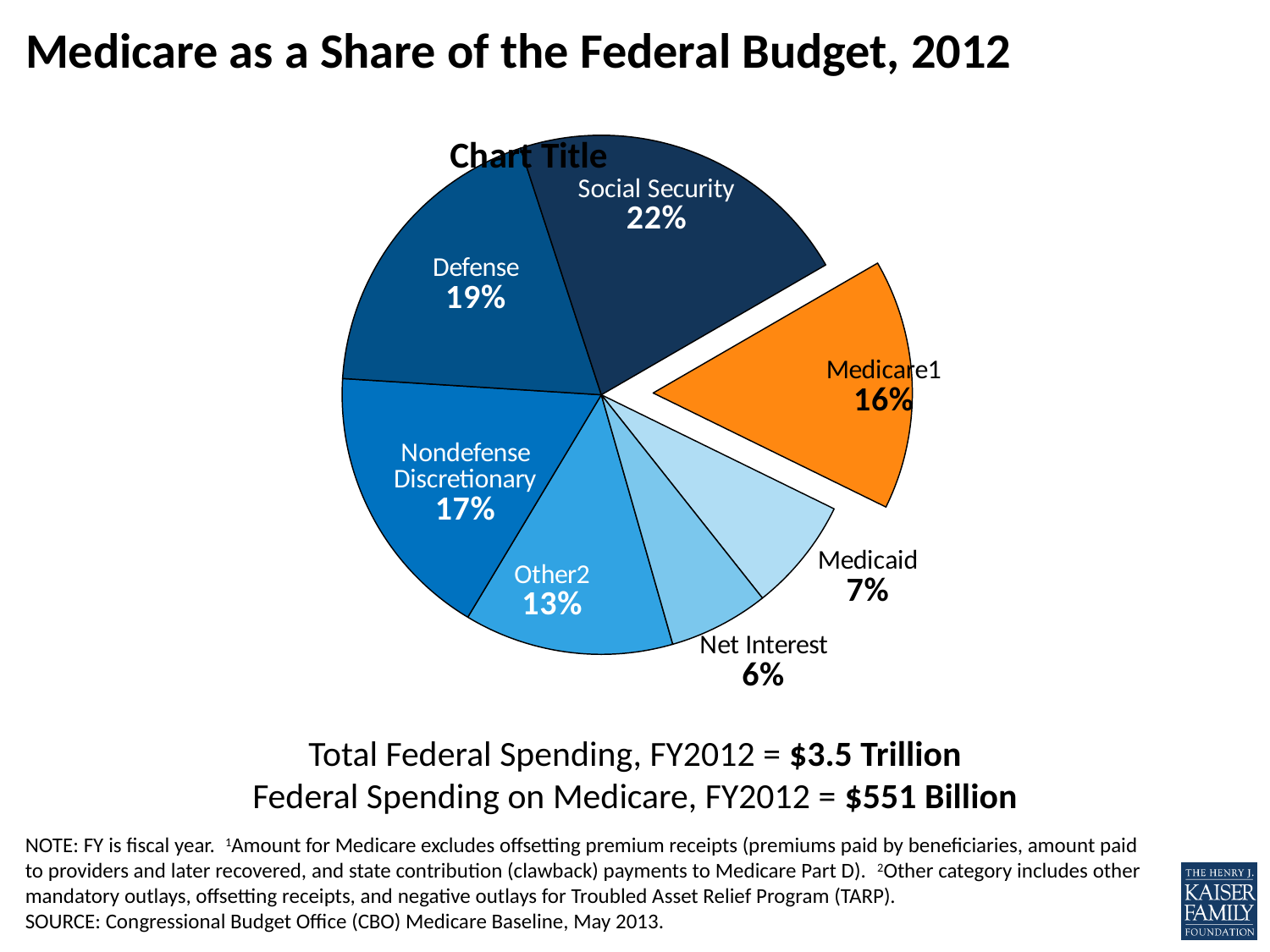
What type of chart is shown on the slide? Pie chart What share does Nondefense Discretionary spending have in the pie chart? 17% What percentage is shown for Medicaid in the pie chart? 7% Which slice of the pie chart is pulled out from the rest and coloured orange? Medicare What is the difference between the Defense share and the Other share in the pie chart? 6 percentage points Which labeled category has the smallest slice of the pie chart? Net Interest Which category has the largest slice of the pie chart? Social Security According to the text below the chart, what was total federal spending in FY2012? $3.5 Trillion What share of the federal budget does Social Security represent in the pie chart? 22% Which is larger in the pie chart, the Defense share or the Nondefense Discretionary share? Defense What percentage of the federal budget is shown for Medicare in the pie chart? 16% How many percentage points larger is the Social Security share than the Medicare share? 6 percentage points